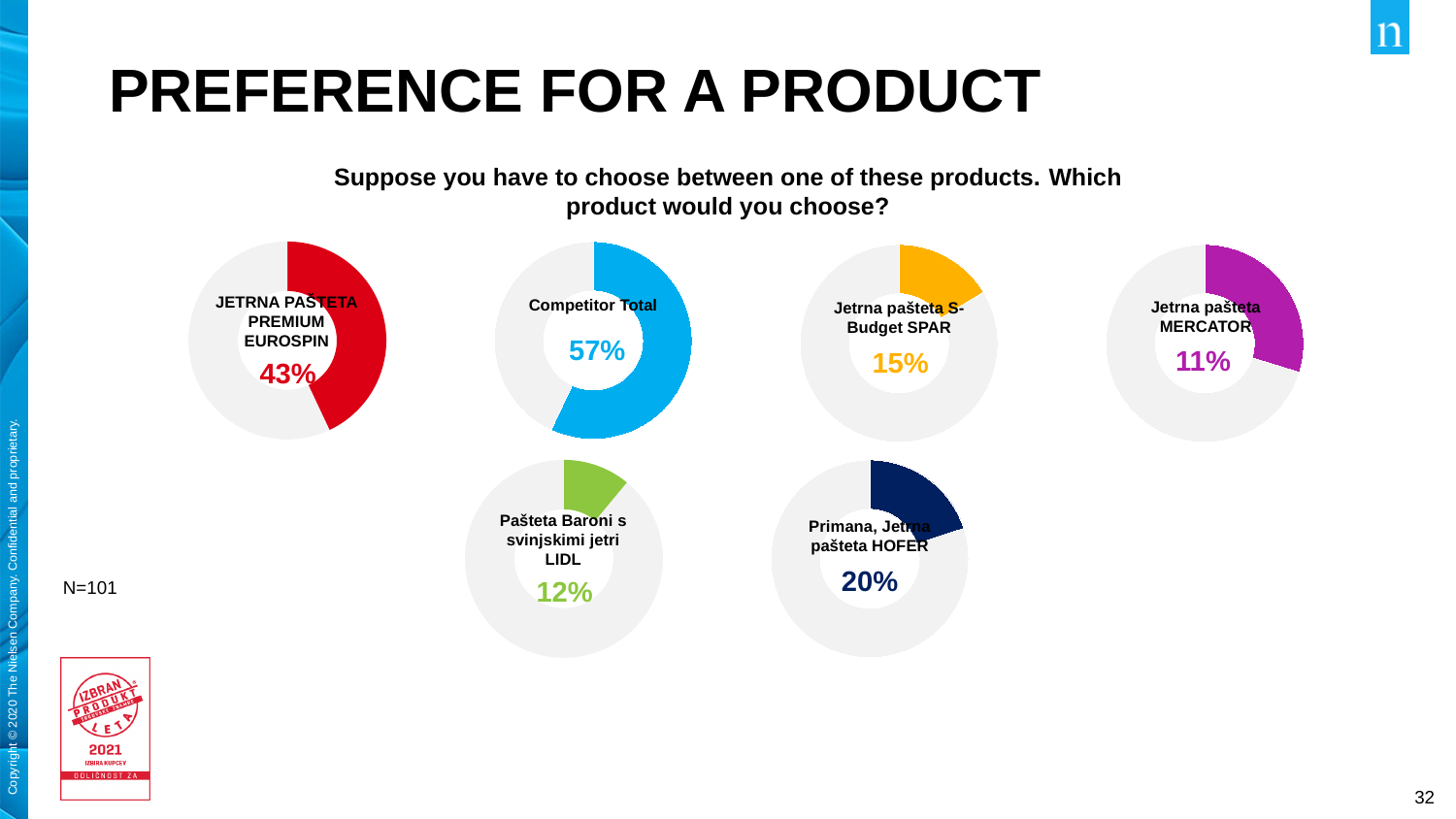
What percentage is shown in the donut chart for JETRNA PAŠTETA PREMIUM EUROSPIN? 43% What percentage is shown in the donut chart for Jetrna pašteta MERCATOR? 11% What percentage is shown in the donut chart for Pašteta Baroni s svinjskimi jetri LIDL? 12% What percentage is shown in the donut chart for Jetrna pašteta S-Budget SPAR? 15% What percentage is shown in the donut chart for Primana, Jetrna pašteta HOFER? 20% What percentage is shown in the Competitor Total donut chart? 57% What type of chart is used to show the preference for each product on this slide? Donut (pie) chart What is the difference in percentage points between the Competitor Total donut chart and the JETRNA PAŠTETA PREMIUM EUROSPIN donut chart? 14 percentage points Among the competitor product donut charts (SPAR, MERCATOR, LIDL, HOFER), which product has the lowest percentage? Jetrna pašteta MERCATOR How many donut charts are shown on the slide? 6 Which has a larger percentage: the Jetrna pašteta S-Budget SPAR donut chart or the Pašteta Baroni s svinjskimi jetri LIDL donut chart? Jetrna pašteta S-Budget SPAR Among the competitor product donut charts (SPAR, MERCATOR, LIDL, HOFER), which product has the highest percentage? Primana, Jetrna pašteta HOFER